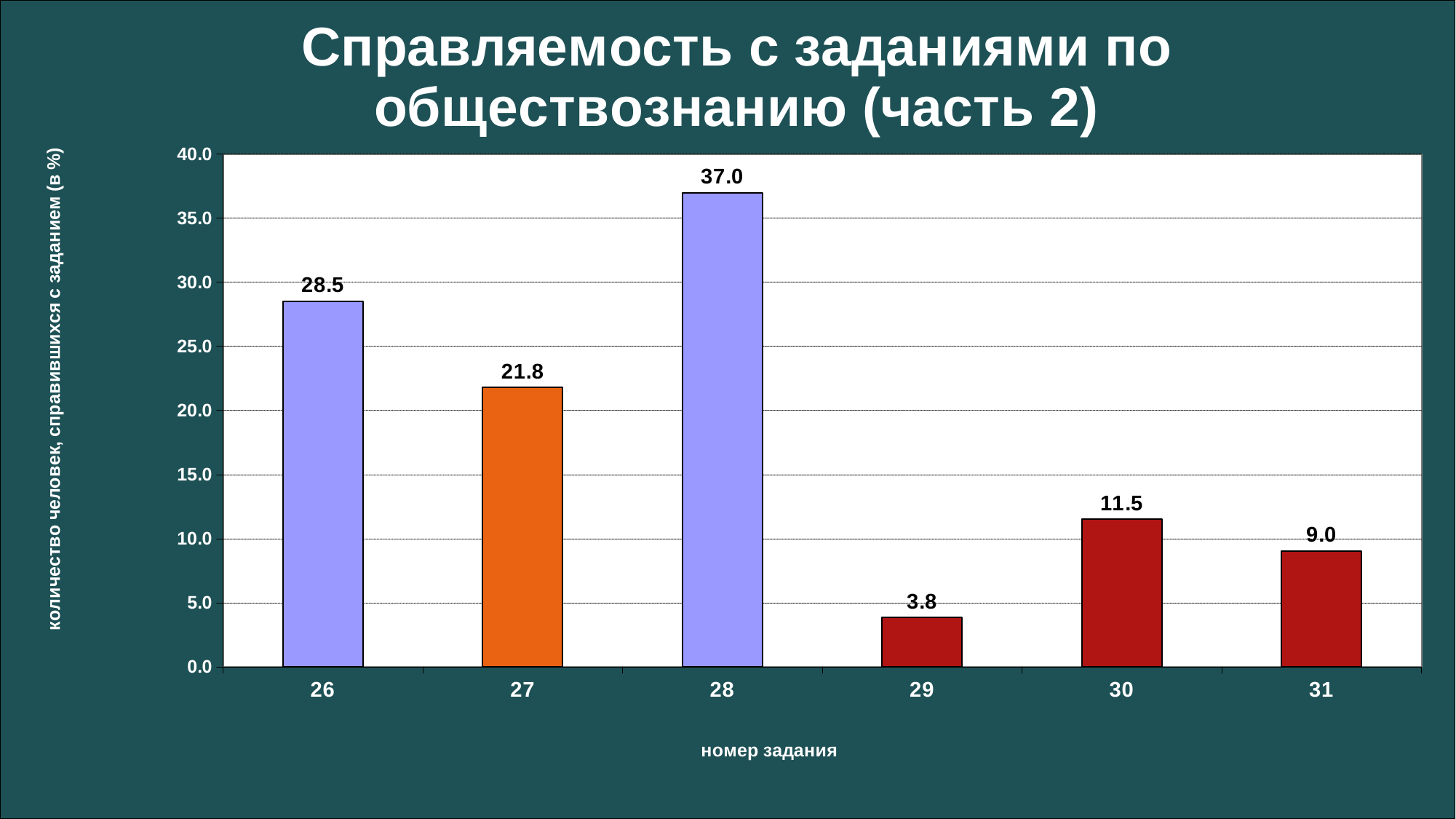
Which has a larger value, task 27 or task 30? 27 What is the difference between the values for task 26 and task 27? 6.7 Which task number has the highest value? 28 What is the label of the x axis? номер задания What is the value for task 29? 3.8 Is the value for task 26 greater or less than 25.0? greater What is the value for task 31? 9.0 How many task numbers are shown on the x axis? 6 Which task number has the lowest value? 29 What kind of chart is shown on the slide? bar chart What is the value for task 28? 37.0 What is the difference between the values for task 30 and task 31? 2.5